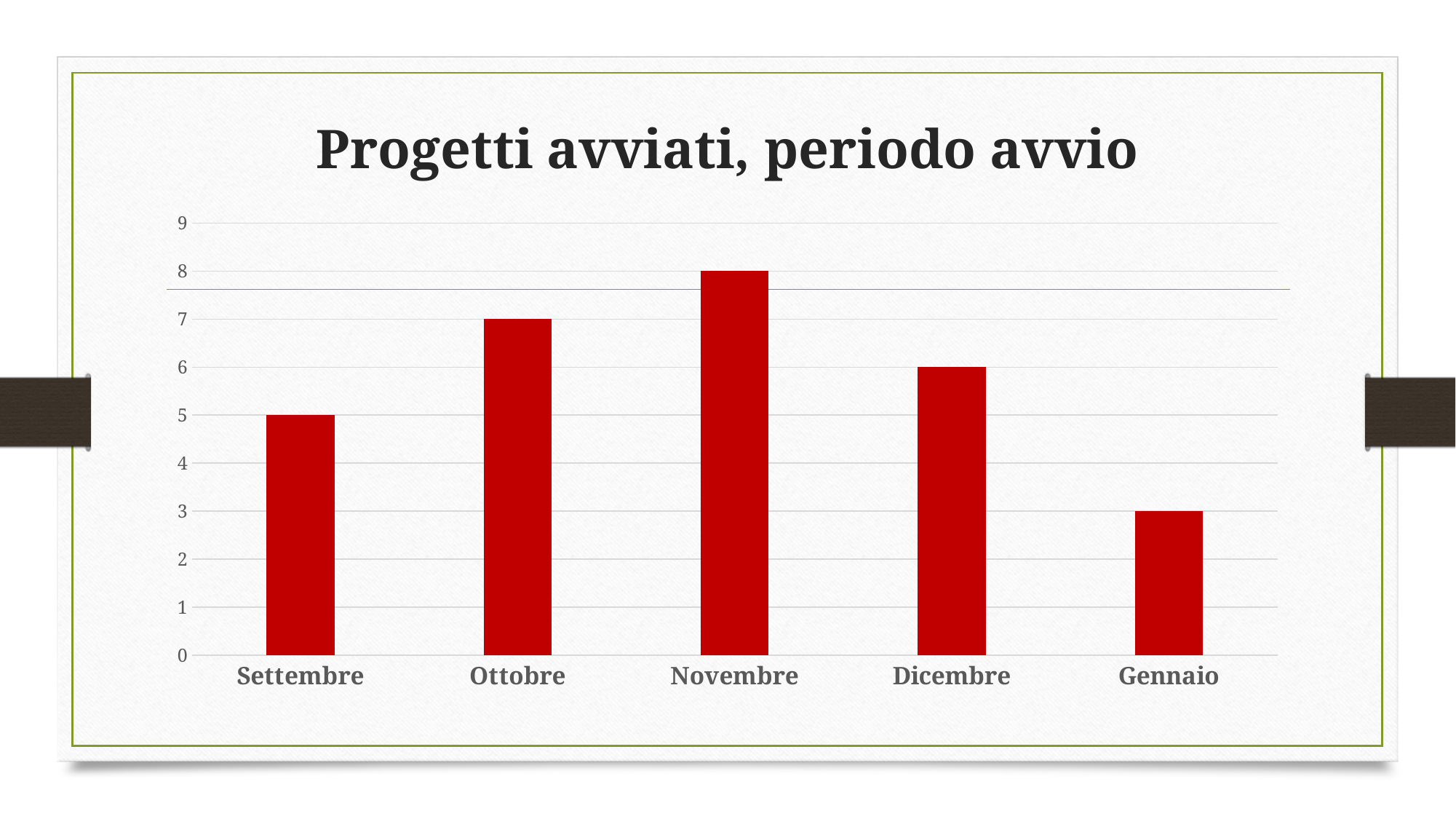
Which is larger, the value for Ottobre or the value for Dicembre? Ottobre What is the value for Gennaio? 3 Which month has the lowest value? Gennaio What is the difference between the values for Novembre and Gennaio? 5 What is the difference between the values for Ottobre and Dicembre? 1 What is the title of the chart? Progetti avviati, periodo avvio What is the value for Settembre? 5 How many months are shown on the x axis? 5 Which month has the highest value? Novembre What kind of chart is shown on the slide? bar chart What is the value for Novembre? 8 Is the value for Dicembre greater or less than 4? greater